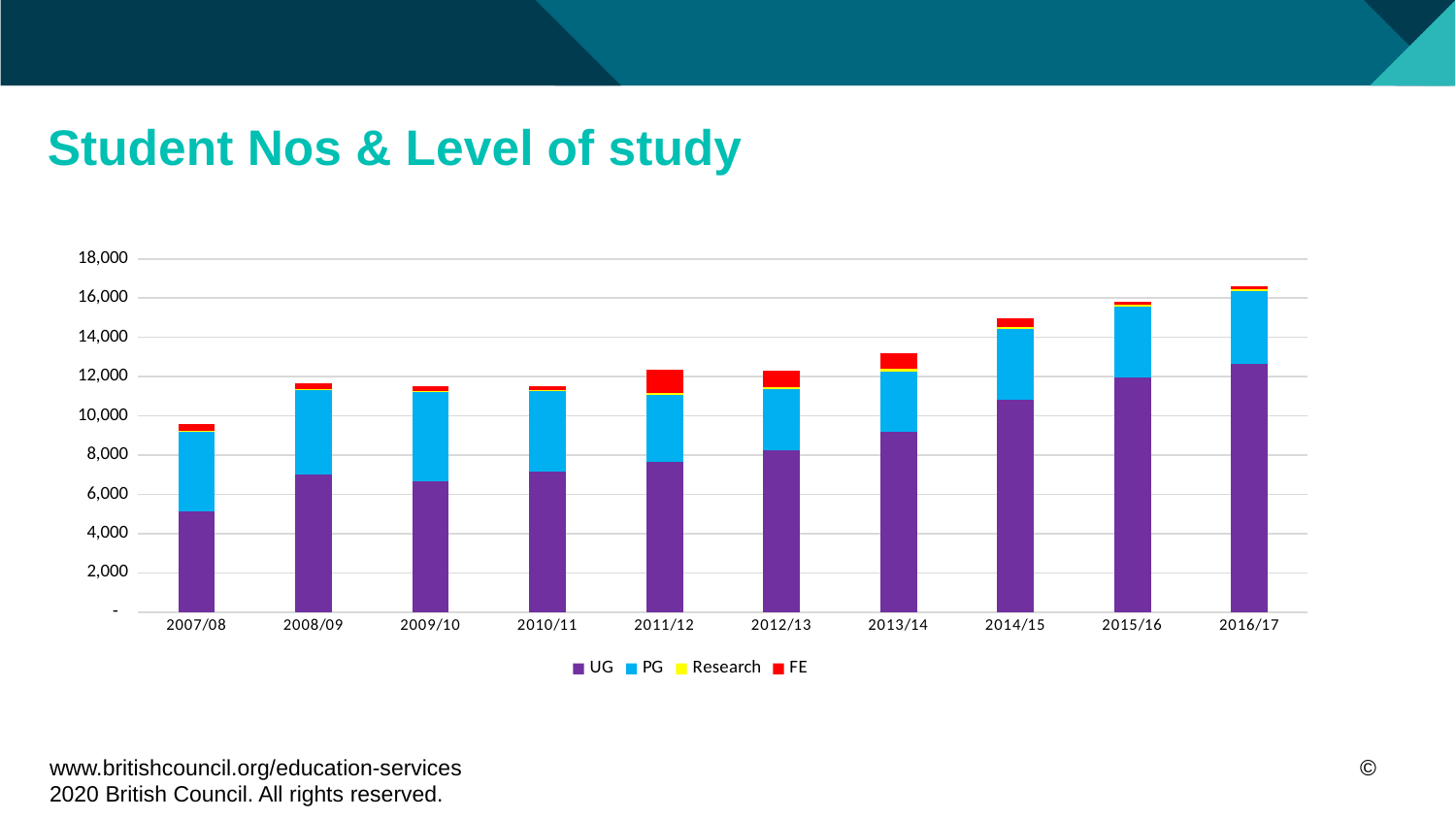
Is the total stacked bar for 2007/08 greater or less than 10,000? less Which academic year has the shortest stacked bar? 2007/08 Is the UG value for 2016/17 greater or less than 12,000? greater Does the UG series generally rise or fall from 2007/08 to 2016/17? rise How many academic years are shown on the x axis? 10 Is the UG value for 2007/08 greater or less than 6,000? less Which is larger, the UG value for 2016/17 or the UG value for 2007/08? 2016/17 How many series does the legend list? 4 What is the title of the chart? Student Nos & Level of study What kind of chart is shown on the slide? stacked bar chart Which academic year has the tallest stacked bar? 2016/17